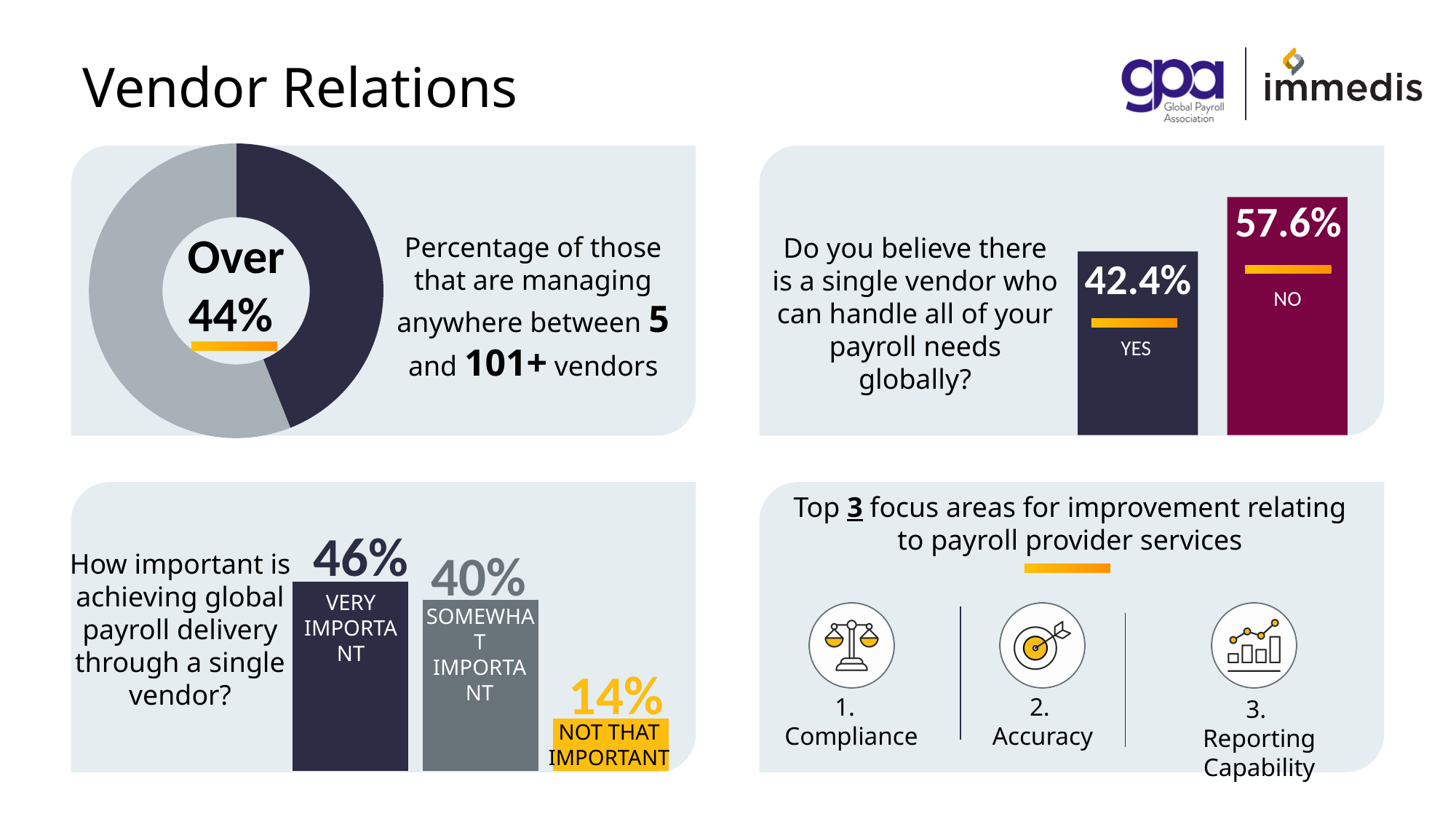
In the bottom-left chart on how important achieving global payroll delivery through a single vendor is, what percentage said VERY IMPORTANT? 46% In the top-right chart about whether a single vendor can handle all payroll needs globally, what percentage answered NO? 57.6% In the bottom-left chart on the importance of a single vendor for global payroll delivery, which category has the lowest percentage? NOT THAT IMPORTANT In the top-right chart about whether a single vendor can handle all payroll needs globally, what percentage answered YES? 42.4% What kind of chart is used in the top-right panel about a single vendor handling all payroll needs? Bar chart In the top-right chart about a single vendor handling all payroll needs, which response has the higher percentage? NO In the bottom-left chart on the importance of a single vendor for global payroll delivery, what percentage said NOT THAT IMPORTANT? 14% In the bottom-left chart on the importance of a single vendor for global payroll delivery, do the values rise or fall from left to right? Fall In the bottom-left chart on the importance of a single vendor for global payroll delivery, what is the difference between VERY IMPORTANT and SOMEWHAT IMPORTANT? 6% How many categories are shown in the bottom-left chart on the importance of a single vendor for global payroll delivery? 3 In the top-right chart about a single vendor handling all payroll needs, what is the difference between the NO and YES percentages? 15.2% What value is printed in the centre of the top-left donut chart about managing between 5 and 101+ vendors? Over 44%